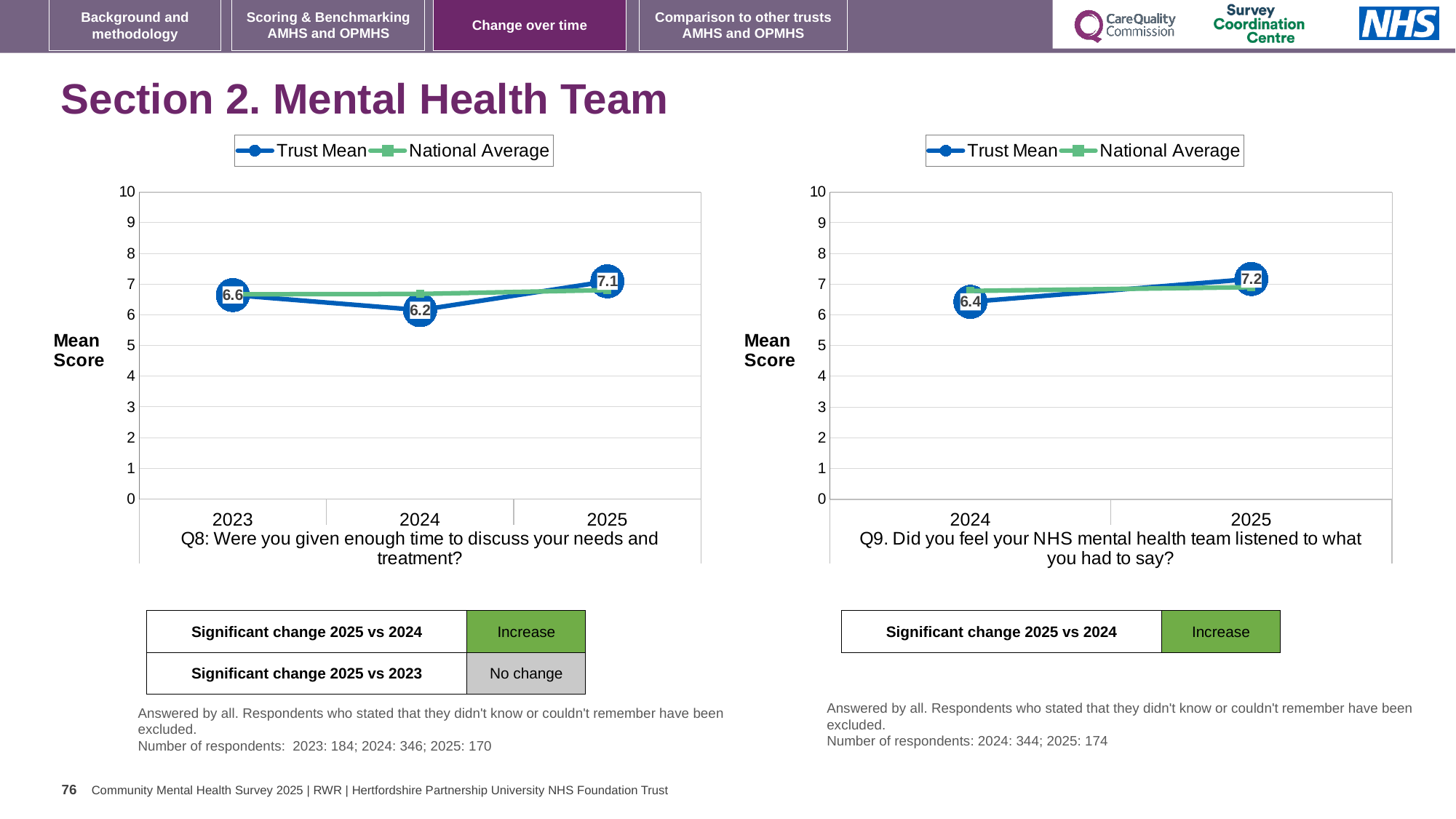
On the Q9 chart (right), what is the Trust Mean for 2024? 6.4 On the Q8 chart (left), what is the Trust Mean for 2024? 6.2 On the Q8 chart (left), what is the Trust Mean for 2025? 7.1 On the Q9 chart (right), what is the Trust Mean for 2025? 7.2 On the Q8 chart (left), how many years are shown on the x axis? 3 On the Q8 chart (left), which year has the lowest Trust Mean? 2024 On the Q8 chart (left), what is the difference between the Trust Mean for 2025 and 2024? 0.9 On the Q9 chart (right), how many series does the legend list? 2 What type of chart is the Q9 chart (right)? Line chart On the Q8 chart (left), which year has the highest Trust Mean? 2025 On the Q8 chart (left), what is the Trust Mean for 2023? 6.6 On the Q9 chart (right), what is the difference between the Trust Mean for 2025 and 2024? 0.8